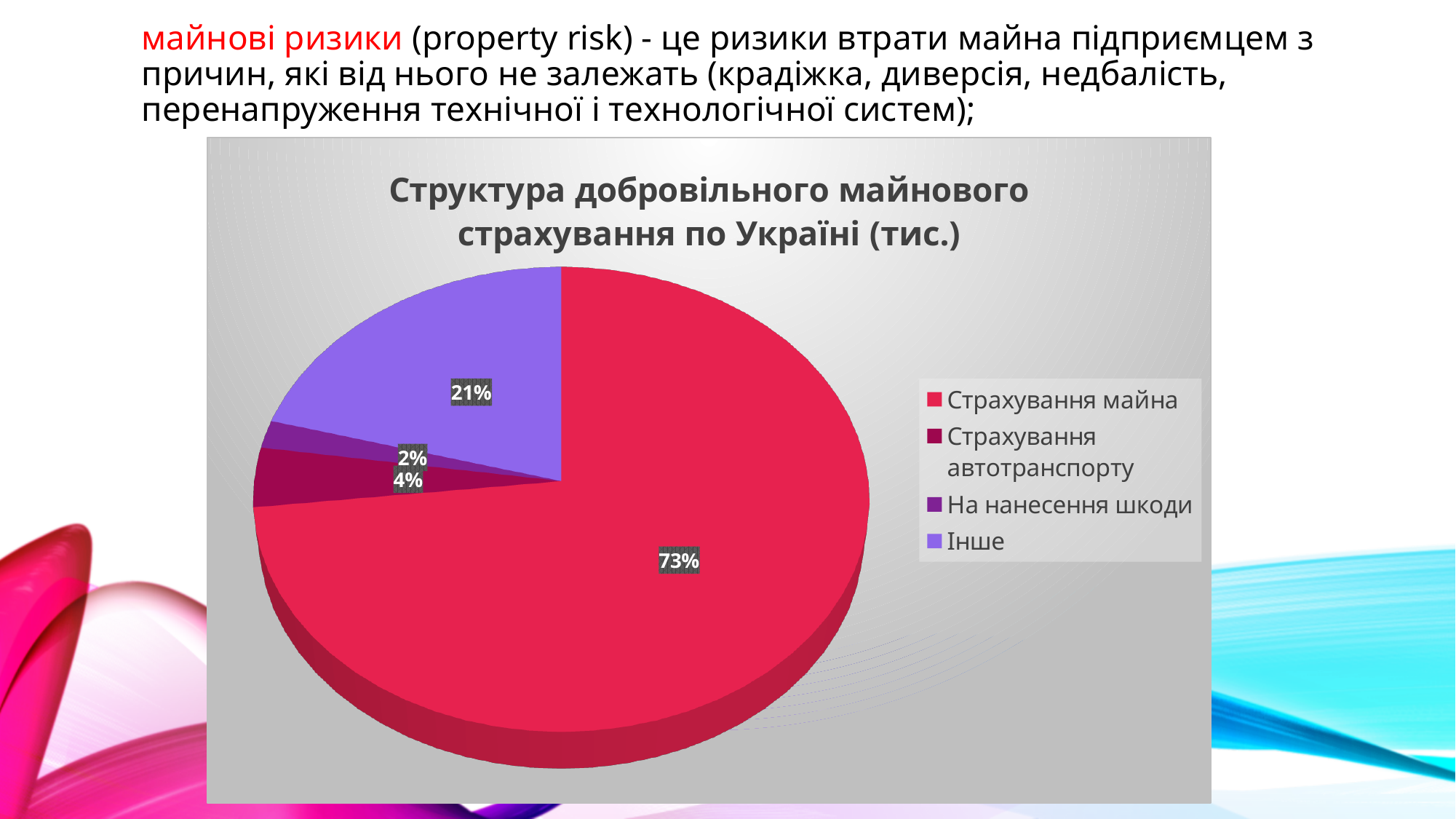
Which is larger, Інше or Страхування автотранспорту? Інше Which category has the smallest slice? На нанесення шкоди What is the title of the chart? Структура добровільного майнового страхування по Україні (тис.) How many slices does the pie chart have? 4 What share of the pie is Страхування майна? 73% What share of the pie is Інше? 21% What kind of chart is shown on the slide? pie chart Which category has the largest slice? Страхування майна What is the difference in percentage points between Страхування майна and Інше? 52 How many entries does the legend list? 4 What share of the pie is Страхування автотранспорту? 4%